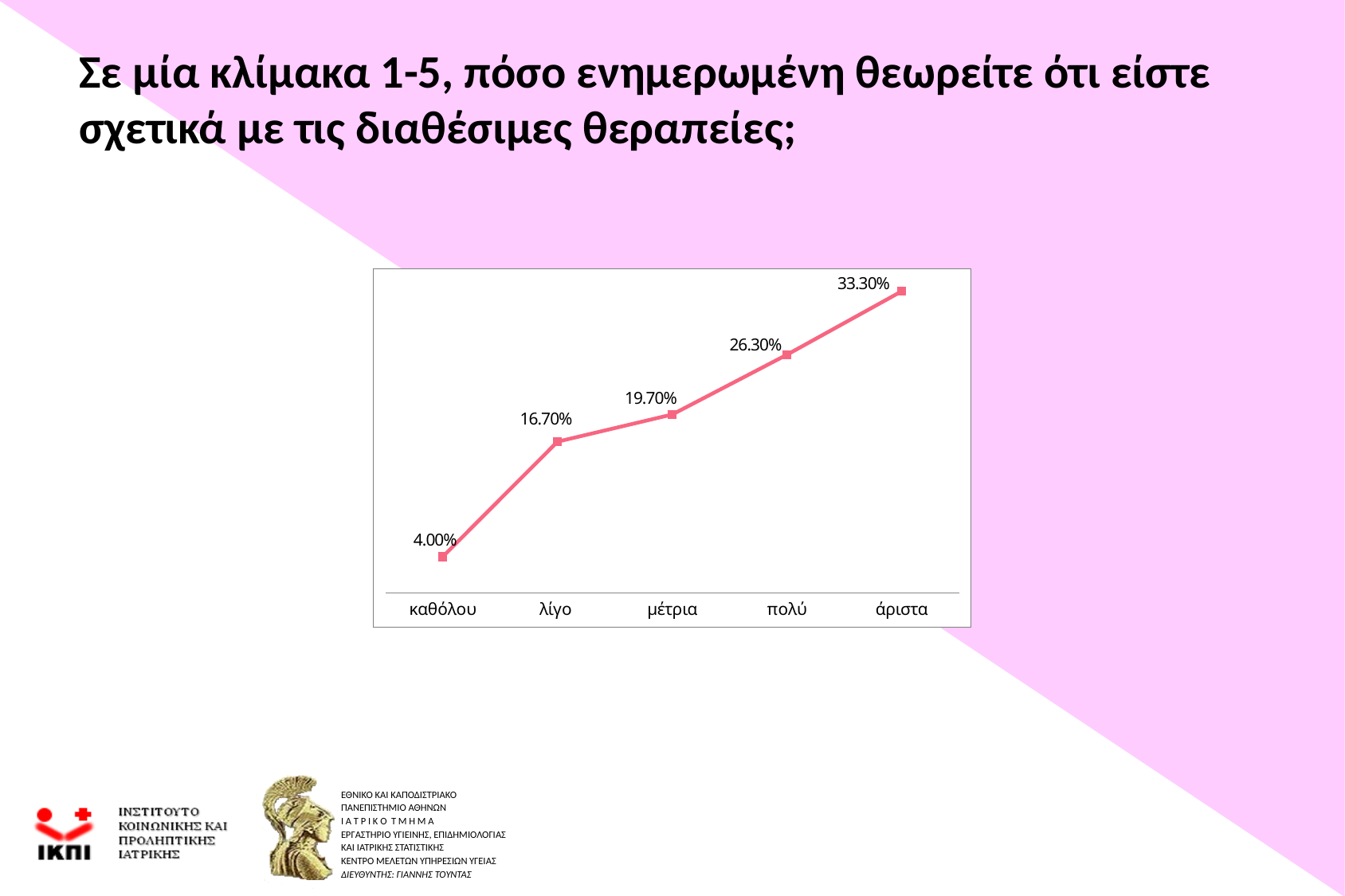
What kind of chart is shown on the slide? line chart How many categories are shown on the x axis? 5 Which category has the highest value? άριστα Which category has the lowest value? καθόλου What is the difference between the values for "λίγο" and "καθόλου"? 12.70% What is the value for "άριστα"? 33.30% What is the value for "καθόλου"? 4.00% Which is larger, the value for "λίγο" or the value for "μέτρια"? μέτρια What is the value for "μέτρια"? 19.70% What is the difference between the values for "άριστα" and "πολύ"? 7.00% What is the value for "πολύ"? 26.30% Do the values rise or fall from "καθόλου" to "άριστα"? rise